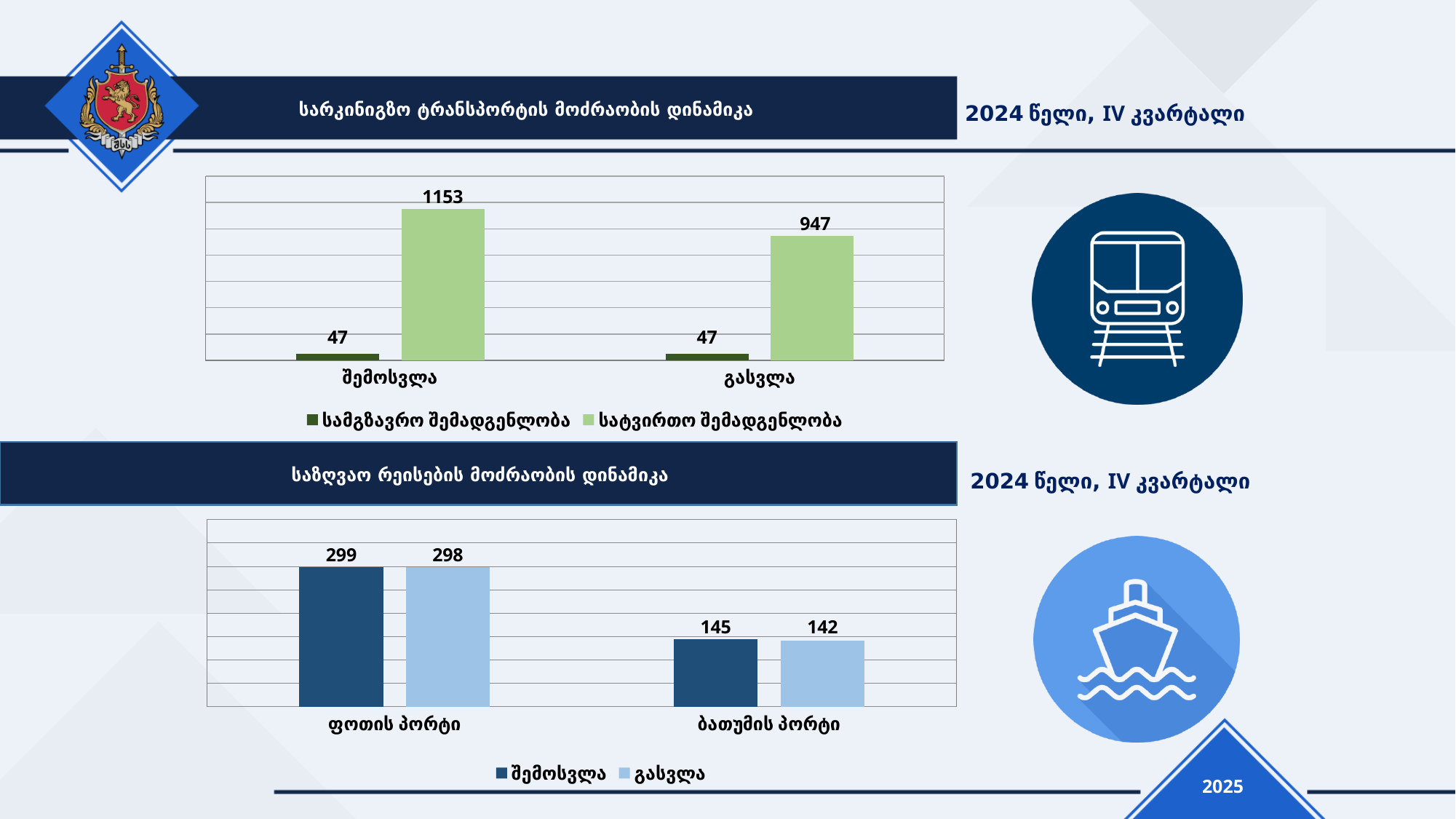
In the bottom chart (საზღვაო რეისების მოძრაობის დინამიკა), what is the difference between the შემოსვლა values for ფოთის პორტი and ბათუმის პორტი? 154 In the bottom chart (საზღვაო რეისების მოძრაობის დინამიკა), which port has the larger გასვლა value, ფოთის პორტი or ბათუმის პორტი? ფოთის პორტი In the top chart (სარკინიგზო ტრანსპორტის მოძრაობის დინამიკა), which bar has the highest value? სატვირთო შემადგენლობა for შემოსვლა In the top chart (სარკინიგზო ტრანსპორტის მოძრაობის დინამიკა), what is the value of სამგზავრო შემადგენლობა for შემოსვლა? 47 In the top chart (სარკინიგზო ტრანსპორტის მოძრაობის დინამიკა), what is the value of სატვირთო შემადგენლობა for გასვლა? 947 What kind of chart is the bottom chart (საზღვაო რეისების მოძრაობის დინამიკა)? bar chart In the top chart (სარკინიგზო ტრანსპორტის მოძრაობის დინამიკა), what is the difference between the სატვირთო შემადგენლობა values for შემოსვლა and გასვლა? 206 How many series does the legend of the top chart (სარკინიგზო ტრანსპორტის მოძრაობის დინამიკა) list? 2 How many categories are shown on the x axis of the bottom chart (საზღვაო რეისების მოძრაობის დინამიკა)? 2 In the bottom chart (საზღვაო რეისების მოძრაობის დინამიკა), what is the შემოსვლა value for ფოთის პორტი? 299 In the top chart (სარკინიგზო ტრანსპორტის მოძრაობის დინამიკა), what is the value of სატვირთო შემადგენლობა for შემოსვლა? 1153 In the bottom chart (საზღვაო რეისების მოძრაობის დინამიკა), what is the გასვლა value for ბათუმის პორტი? 142